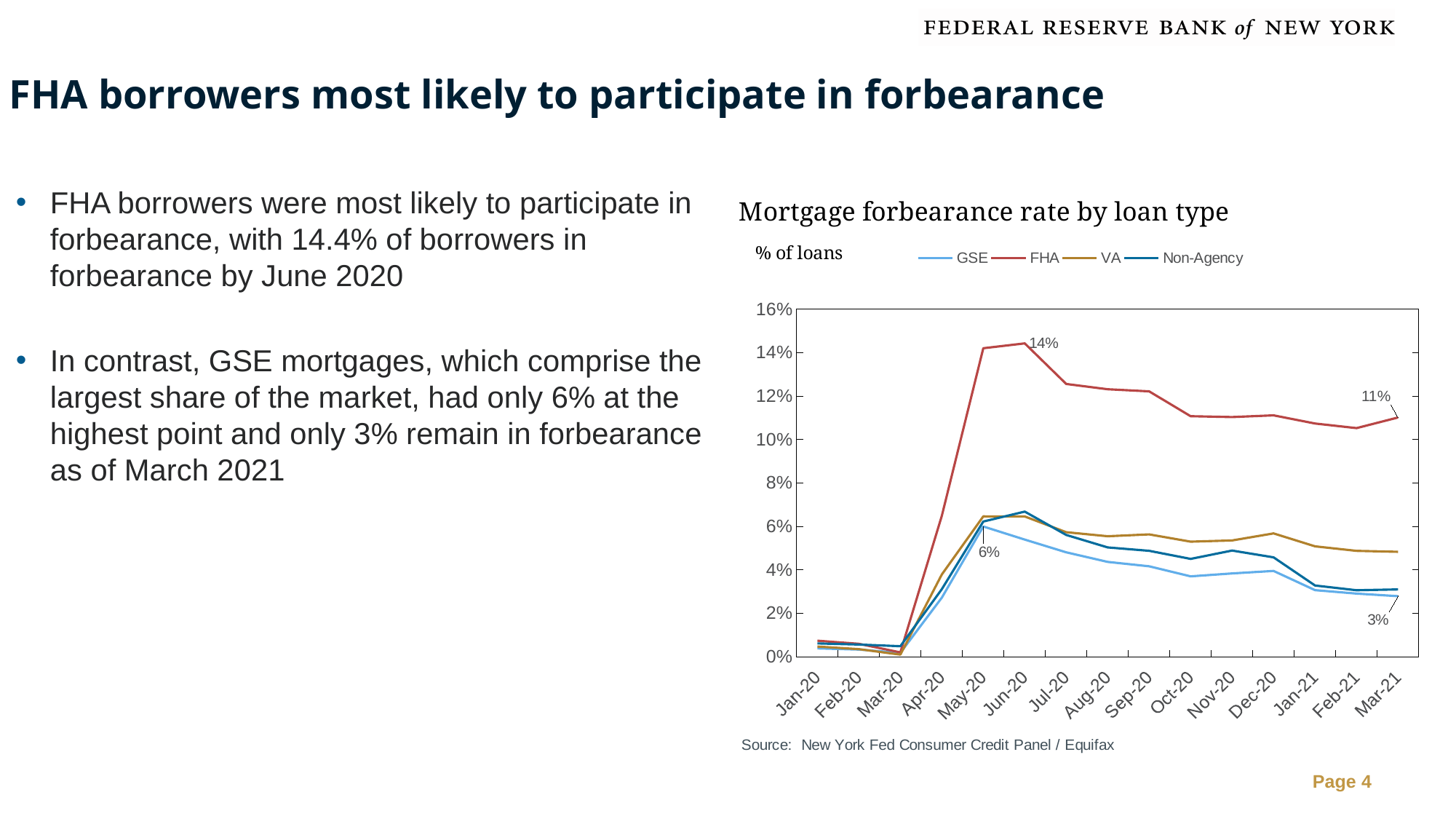
Is the FHA forbearance rate in Oct-20 greater or less than 12%? less Which loan type has the highest forbearance rate in Jun-20? FHA In Mar-21, which is higher, the VA or the GSE forbearance rate? VA What is the GSE forbearance rate in May-20? 6% Does the FHA forbearance rate rise or fall from Jun-20 to Mar-21? fall How many months are shown on the x axis of the chart? 15 What is the FHA forbearance rate in Jun-20? 14% What kind of chart is shown on the slide? line chart By how many percentage points did the FHA forbearance rate fall from Jun-20 to Mar-21? 3 percentage points What is the FHA forbearance rate in Mar-21? 11% What is the GSE forbearance rate in Mar-21? 3% How many series does the legend of the chart list? 4